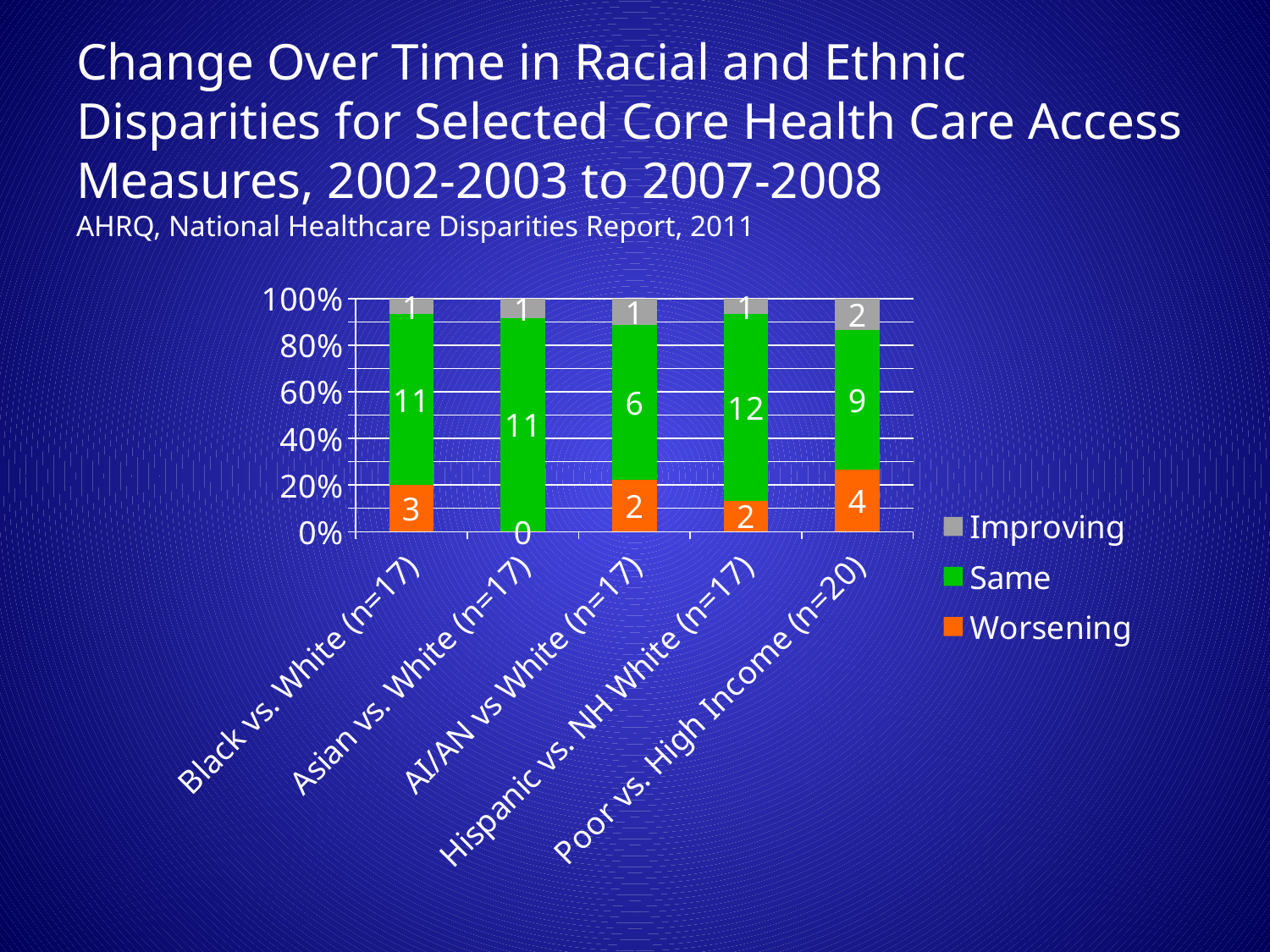
What is the total of the three labelled values in the AI/AN vs White (n=17) bar? 9 What is the difference between the Same values for Hispanic vs. NH White (n=17) and AI/AN vs White (n=17)? 6 What is the Worsening value for Black vs. White (n=17)? 3 Which category has the highest Worsening value? Poor vs. High Income (n=20) Which category has the lowest Same value? AI/AN vs White (n=17) How many series does the legend list? 3 Which is larger, the Worsening value for Black vs. White (n=17) or for AI/AN vs White (n=17)? Black vs. White (n=17) How many categories are shown on the x axis? 5 What is the Worsening value for Asian vs. White (n=17)? 0 What kind of chart is shown on the slide? Stacked bar chart What is the Same value for Hispanic vs. NH White (n=17)? 12 What is the Improving value for Poor vs. High Income (n=20)? 2